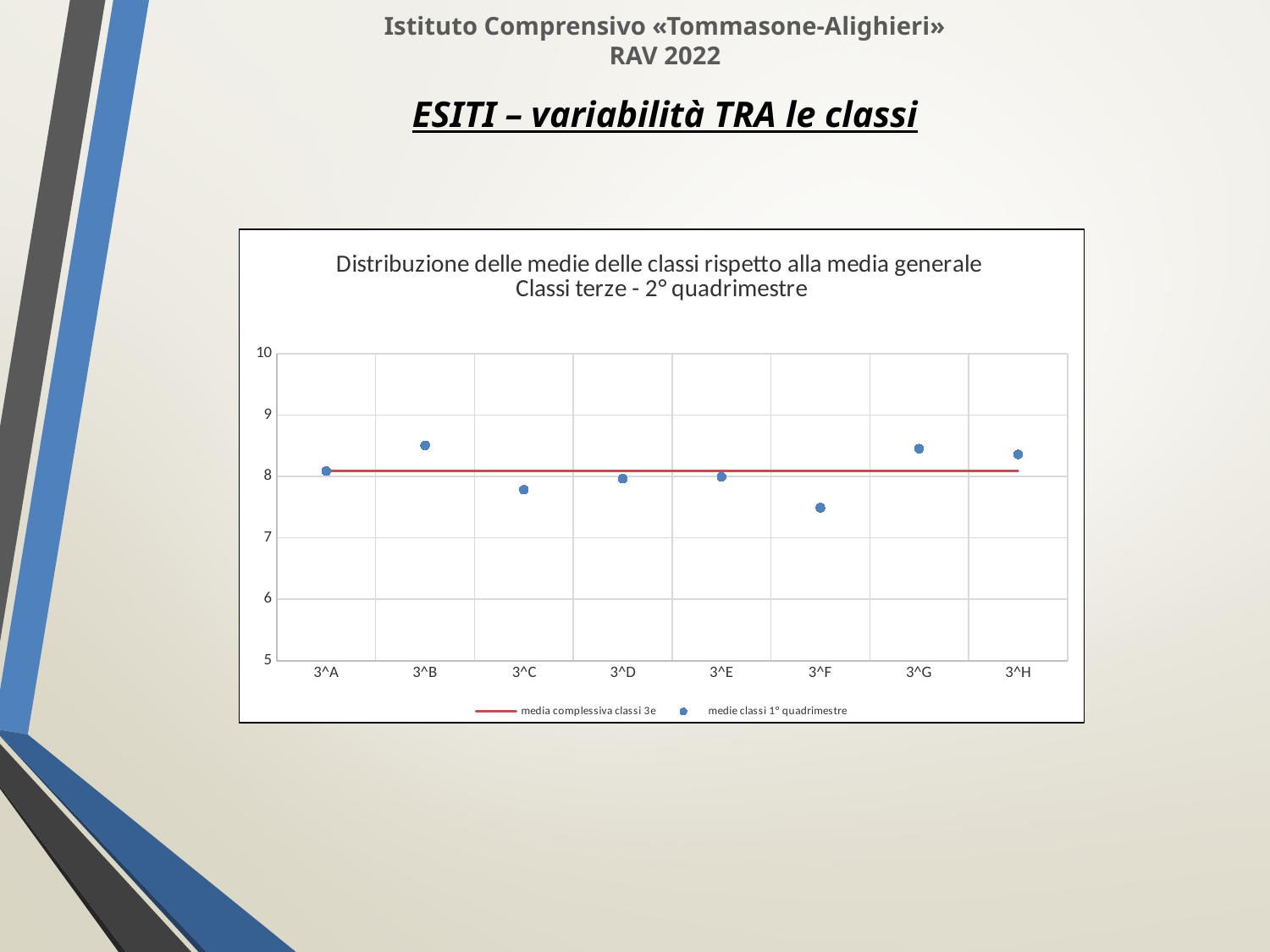
How many classes are plotted along the x axis of the chart? 8 Which class has the lowest average in the chart? 3^F Which has the higher average, 3^B or 3^F? 3^B Is the value for 3^F greater or less than 8? less What does the red horizontal line in the chart represent, according to the legend? media complessiva classi 3e Which has the higher average, 3^C or 3^G? 3^G Is the value for 3^B greater or less than 8? greater How many series does the chart legend list? 2 Is the value for 3^G greater or less than 8? greater What is the title of the chart? Distribuzione delle medie delle classi rispetto alla media generale Classi terze - 2° quadrimestre What kind of chart is shown on the slide? line chart